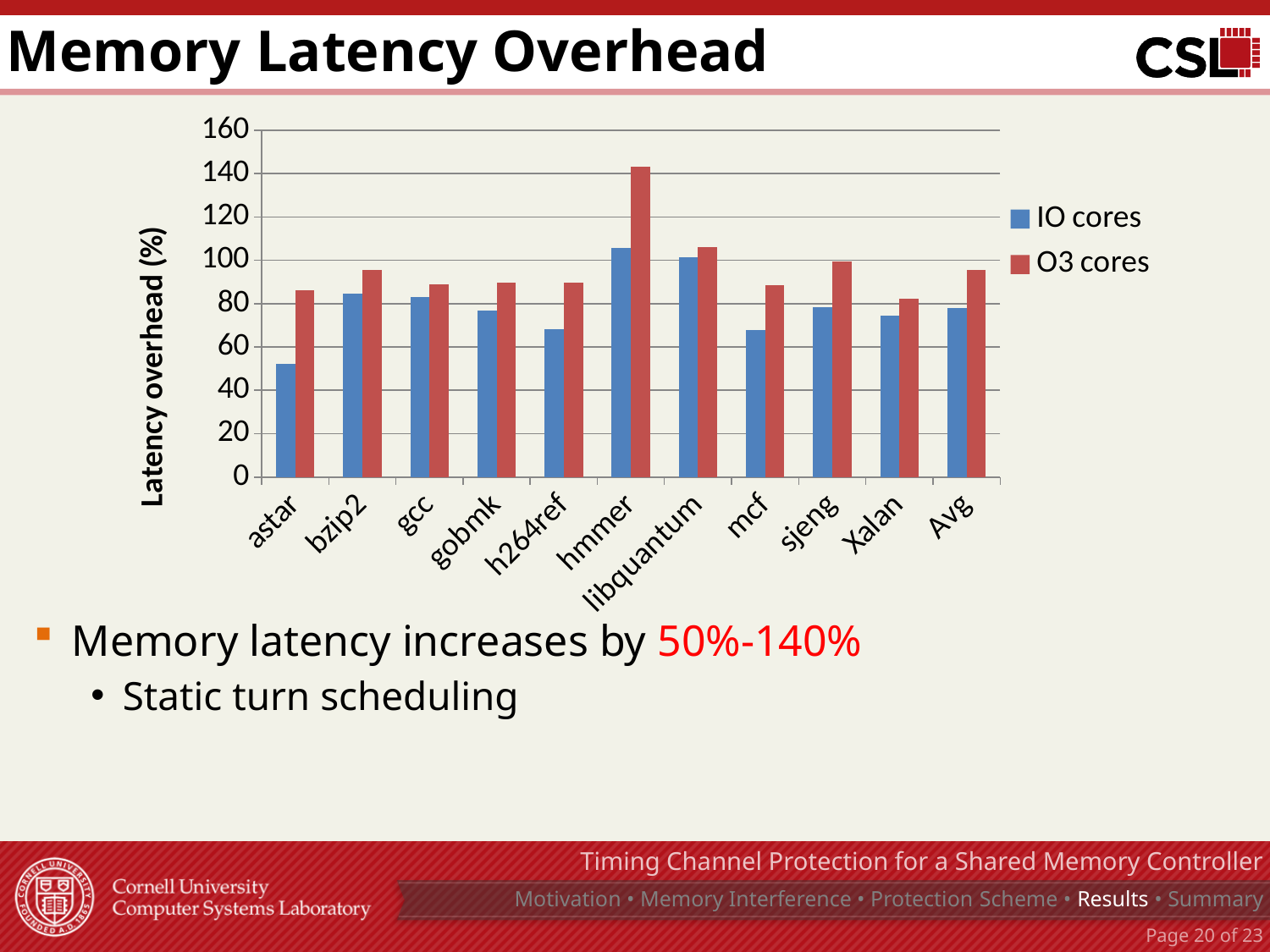
Which is larger: the O3 cores value for hmmer or the O3 cores value for libquantum? hmmer Is the IO cores value for astar greater or less than 60? less What kind of chart is shown on the slide? bar chart Which category has the lowest IO cores value? astar How many series does the legend list? 2 Is the IO cores value for mcf greater or less than 80? less Is the O3 cores value for Avg greater or less than 80? greater What is the label of the y axis? Latency overhead (%) Which category has the highest O3 cores value? hmmer For astar, which series has the larger value, IO cores or O3 cores? O3 cores How many categories are shown on the x axis? 11